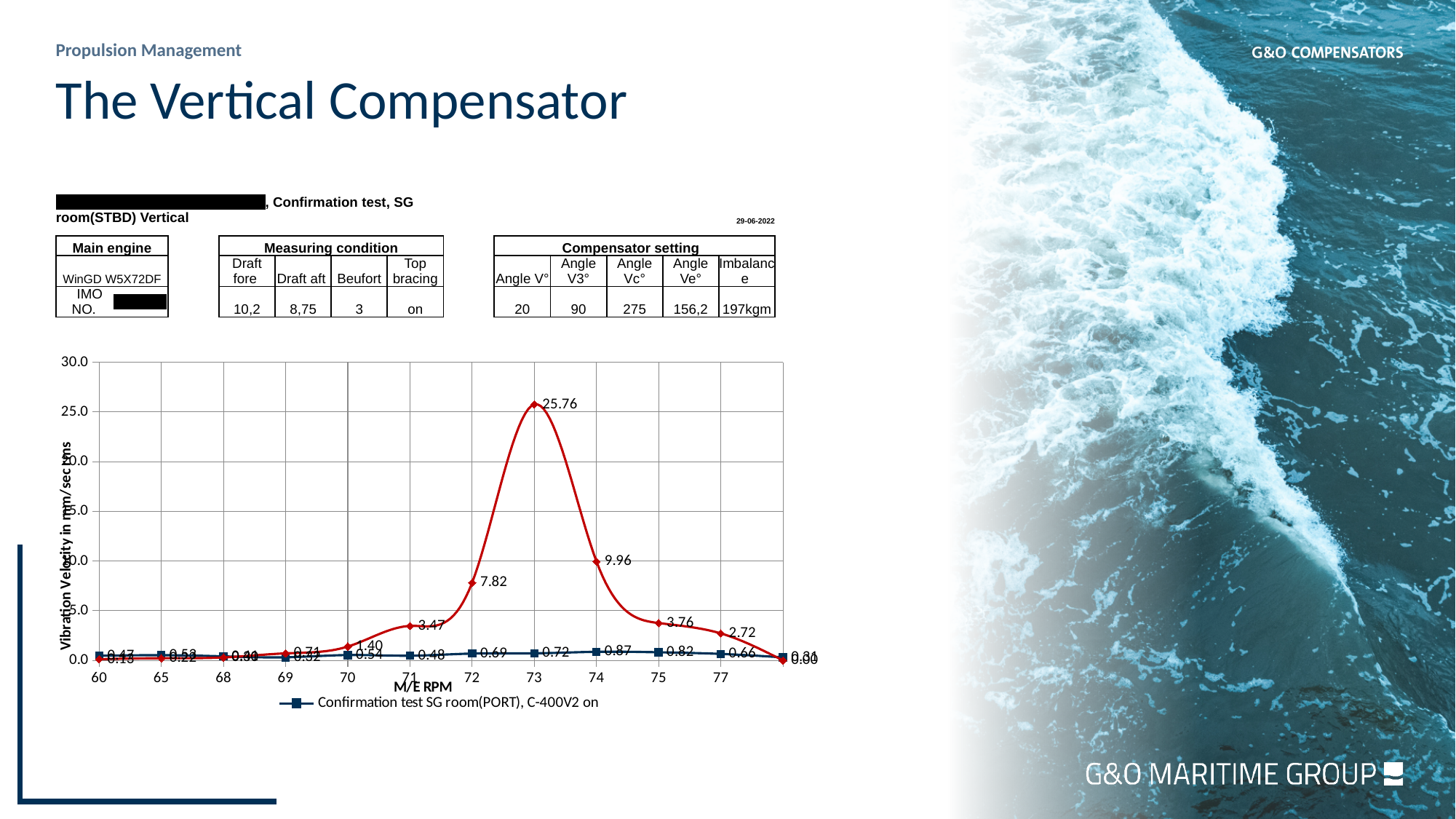
Which is larger for the red line: the value at 72 RPM or at 74 RPM? 74 RPM What is the value of the blue 'Confirmation test SG room(PORT), C-400V2 on' series at 74 RPM? 0.87 What is the title of the vertical axis of the chart? Vibration Velocity in mm/sec rms What is the peak value of the red line at 73 RPM? 25.76 What is the value of the red line at 71 RPM? 3.47 What is the value of the red line at 72 RPM? 7.82 What is the value of the red line at 77 RPM? 2.72 At which M/E RPM does the red line reach its highest vibration velocity? 73 What is the value of the red line at 74 RPM? 9.96 Is the red line's value at 73 RPM greater or less than 20.0? greater What kind of chart is shown on the slide? line chart What is the difference between the red line's values at 73 RPM and 74 RPM? 15.80